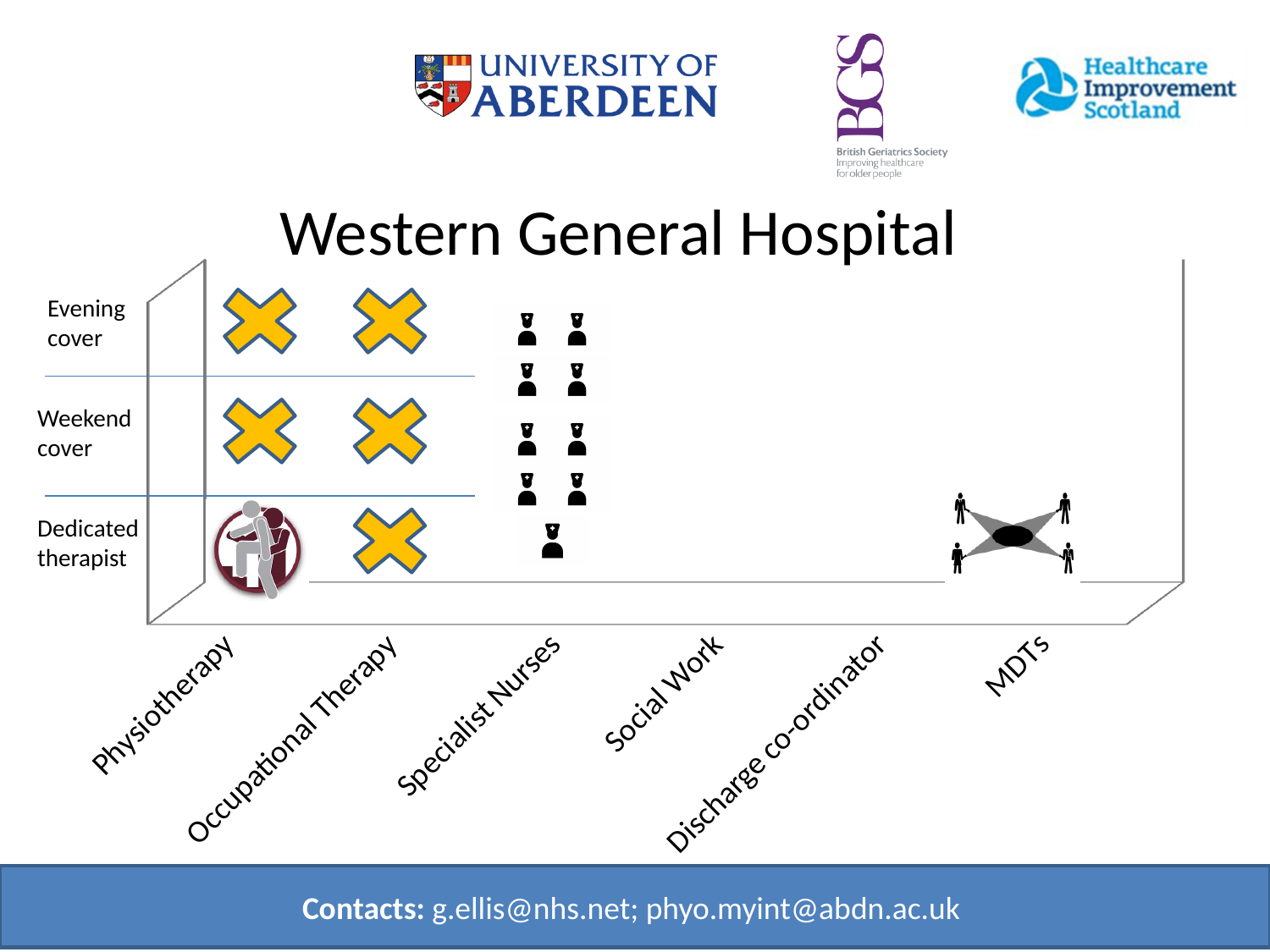
How many categories are listed along the x axis of the chart? 6 Which category shows a cross (X) mark in the Dedicated therapist row? Occupational Therapy Which category shows a therapist-with-patient icon in the Dedicated therapist row? Physiotherapy What is the first category on the x axis of the chart? Physiotherapy What colour are the cross (X) marks in the chart? Yellow Which categories show a cross (X) mark in the Weekend cover row? Physiotherapy and Occupational Therapy How many nurse icons are shown in the Specialist Nurses column? 9 What is the last category on the x axis of the chart? MDTs What is the title of the chart? Western General Hospital Which categories show a cross (X) mark in the Evening cover row? Physiotherapy and Occupational Therapy Which categories on the x axis have no icons or marks in any row? Social Work and Discharge co-ordinator How many row labels are shown on the left side of the chart? 3